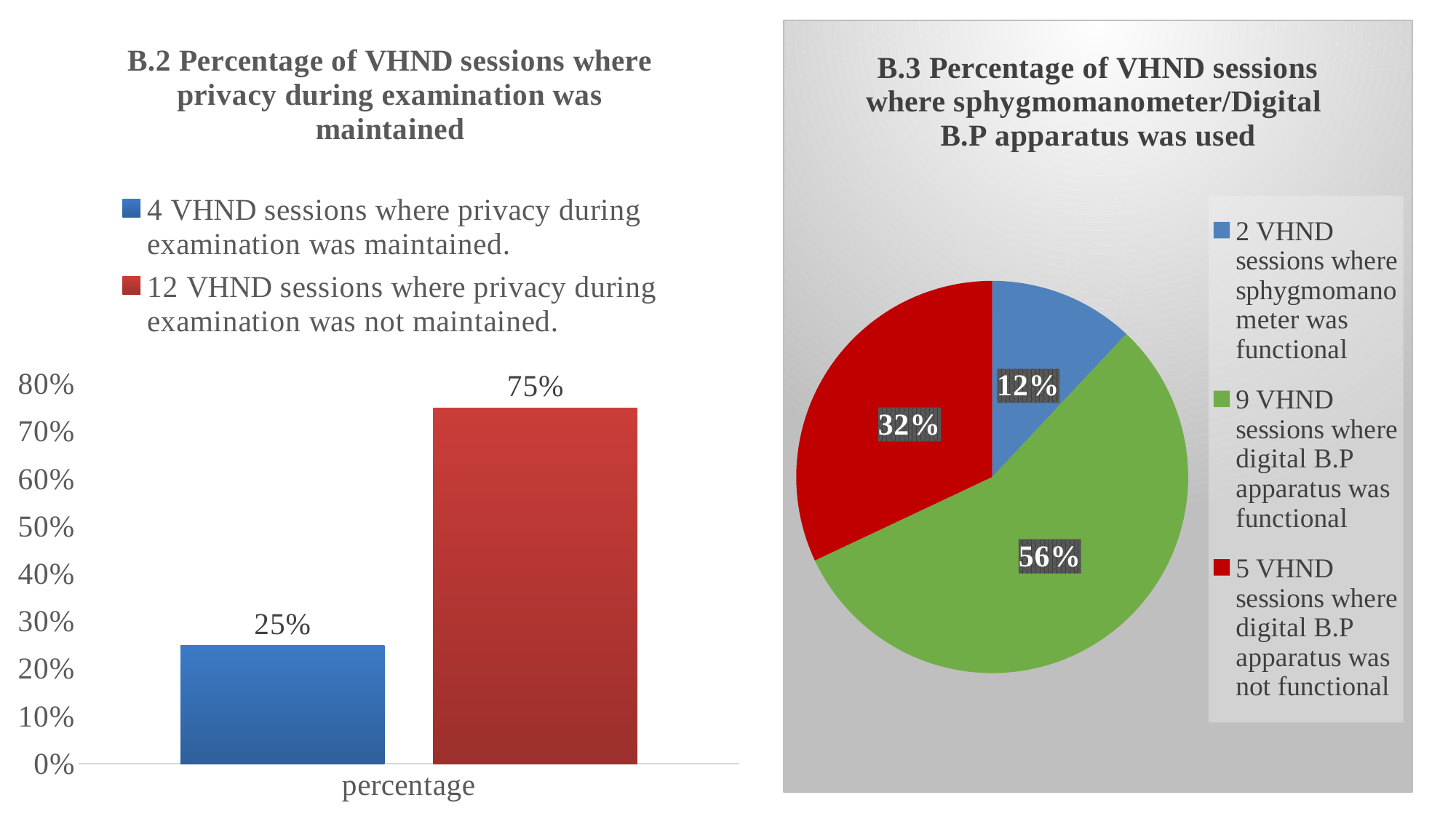
In the B.2 chart, what percentage of VHND sessions had privacy during examination maintained? 25% In the B.3 chart, what share of VHND sessions had a functional sphygmomanometer? 12% What kind of chart is the B.3 chart? pie chart How many series does the legend of the B.2 chart list? 2 In the B.2 chart, what is the difference between the percentage where privacy was not maintained and the percentage where it was maintained? 50% In the B.3 chart, what share of VHND sessions had a functional digital B.P apparatus? 56% In the B.3 chart, which category has the smallest slice? 2 VHND sessions where sphygmomanometer was functional In the B.3 chart, what share of VHND sessions had a non-functional digital B.P apparatus? 32% In the B.2 chart, what percentage of VHND sessions had privacy during examination not maintained? 75% In the B.2 chart, which series has the higher value: privacy maintained or privacy not maintained? 12 VHND sessions where privacy during examination was not maintained. In the B.3 chart, which category has the largest slice? 9 VHND sessions where digital B.P apparatus was functional What kind of chart is the B.2 chart? bar chart